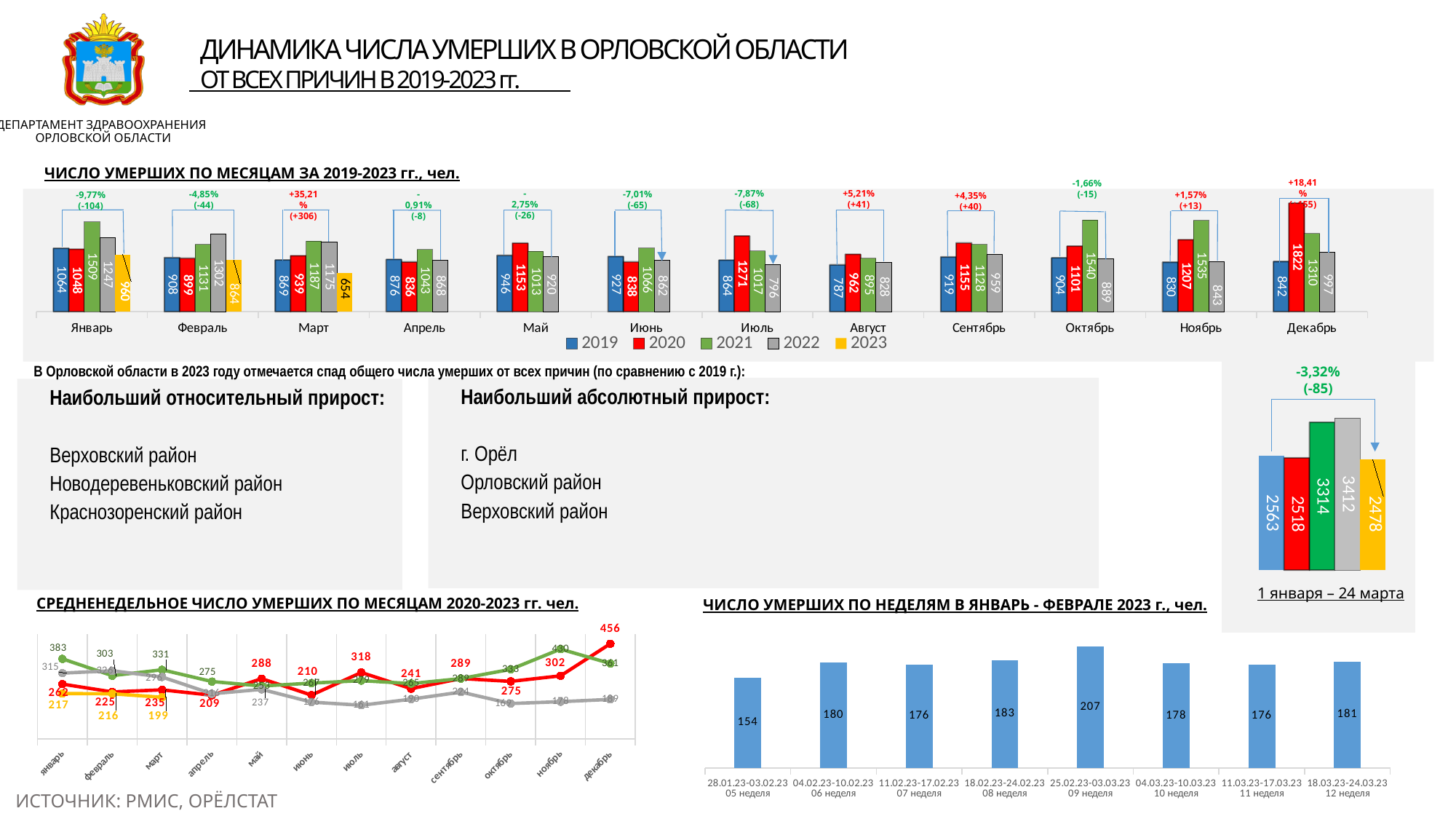
On the chart 'ЧИСЛО УМЕРШИХ ПО МЕСЯЦАМ ЗА 2019-2023 гг., чел.', what is the value for 2023 in Январь? 960 On the small chart labelled '1 января – 24 марта' on the right, what is the value of the yellow (2023) bar? 2478 On the chart 'ЧИСЛО УМЕРШИХ ПО МЕСЯЦАМ ЗА 2019-2023 гг., чел.', how many series does the legend list? 5 On the chart 'ЧИСЛО УМЕРШИХ ПО НЕДЕЛЯМ В ЯНВАРЬ - ФЕВРАЛЕ 2023 г., чел.', how many weeks are shown? 8 On the chart 'ЧИСЛО УМЕРШИХ ПО НЕДЕЛЯМ В ЯНВАРЬ - ФЕВРАЛЕ 2023 г., чел.', which week has the highest value? 09 неделя (25.02.23-03.03.23) On the chart 'ЧИСЛО УМЕРШИХ ПО МЕСЯЦАМ ЗА 2019-2023 гг., чел.', what is the value for 2020 in Декабрь? 1822 On the chart 'ЧИСЛО УМЕРШИХ ПО МЕСЯЦАМ ЗА 2019-2023 гг., чел.', what is the difference between the 2019 and 2023 values in Январь? 104 On the chart 'ЧИСЛО УМЕРШИХ ПО МЕСЯЦАМ ЗА 2019-2023 гг., чел.', which is larger in Март: the 2021 value or the 2023 value? 2021 What kind of chart is 'ЧИСЛО УМЕРШИХ ПО НЕДЕЛЯМ В ЯНВАРЬ - ФЕВРАЛЕ 2023 г., чел.'? bar chart On the chart 'ЧИСЛО УМЕРШИХ ПО НЕДЕЛЯМ В ЯНВАРЬ - ФЕВРАЛЕ 2023 г., чел.', what is the difference between the highest and lowest values? 53 On the small chart labelled '1 января – 24 марта' on the right, which bar has the highest value? 2022 (3412) On the chart 'ЧИСЛО УМЕРШИХ ПО НЕДЕЛЯМ В ЯНВАРЬ - ФЕВРАЛЕ 2023 г., чел.', which week has the lowest value? 05 неделя (28.01.23-03.02.23)